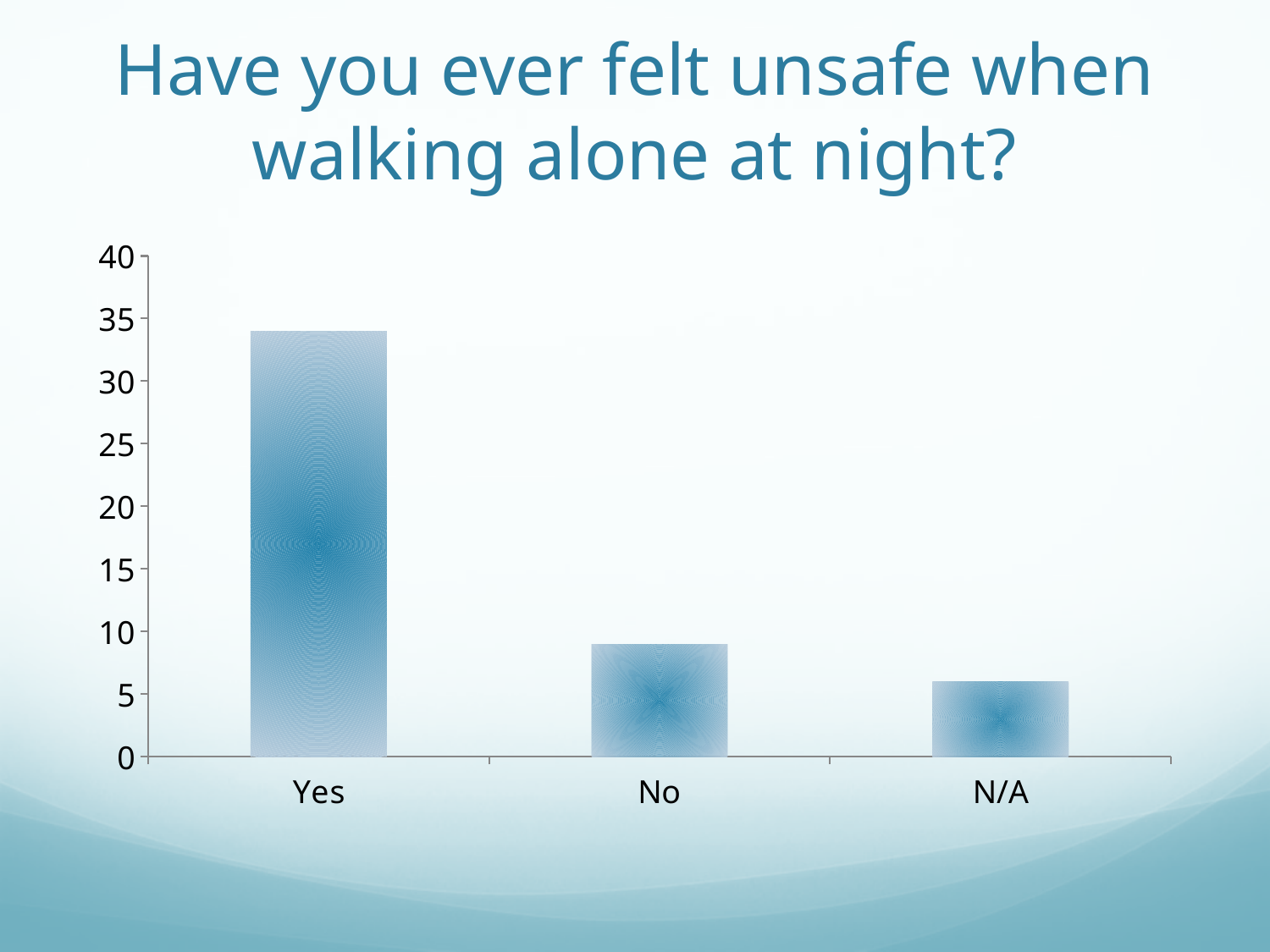
Is the value for No greater or less than 10? less Do the values rise or fall moving from Yes to N/A along the x axis? fall Which is larger, the value for Yes or the value for No? Yes Which category has the highest value in the chart? Yes Which is larger, the value for No or the value for N/A? No How many categories are shown on the x axis of the chart? 3 What kind of chart is shown on the slide? bar chart Is the value for Yes greater or less than 30? greater What is the title of the chart on the slide? Have you ever felt unsafe when walking alone at night? Which category has the lowest value in the chart? N/A Is the value for N/A greater or less than 10? less